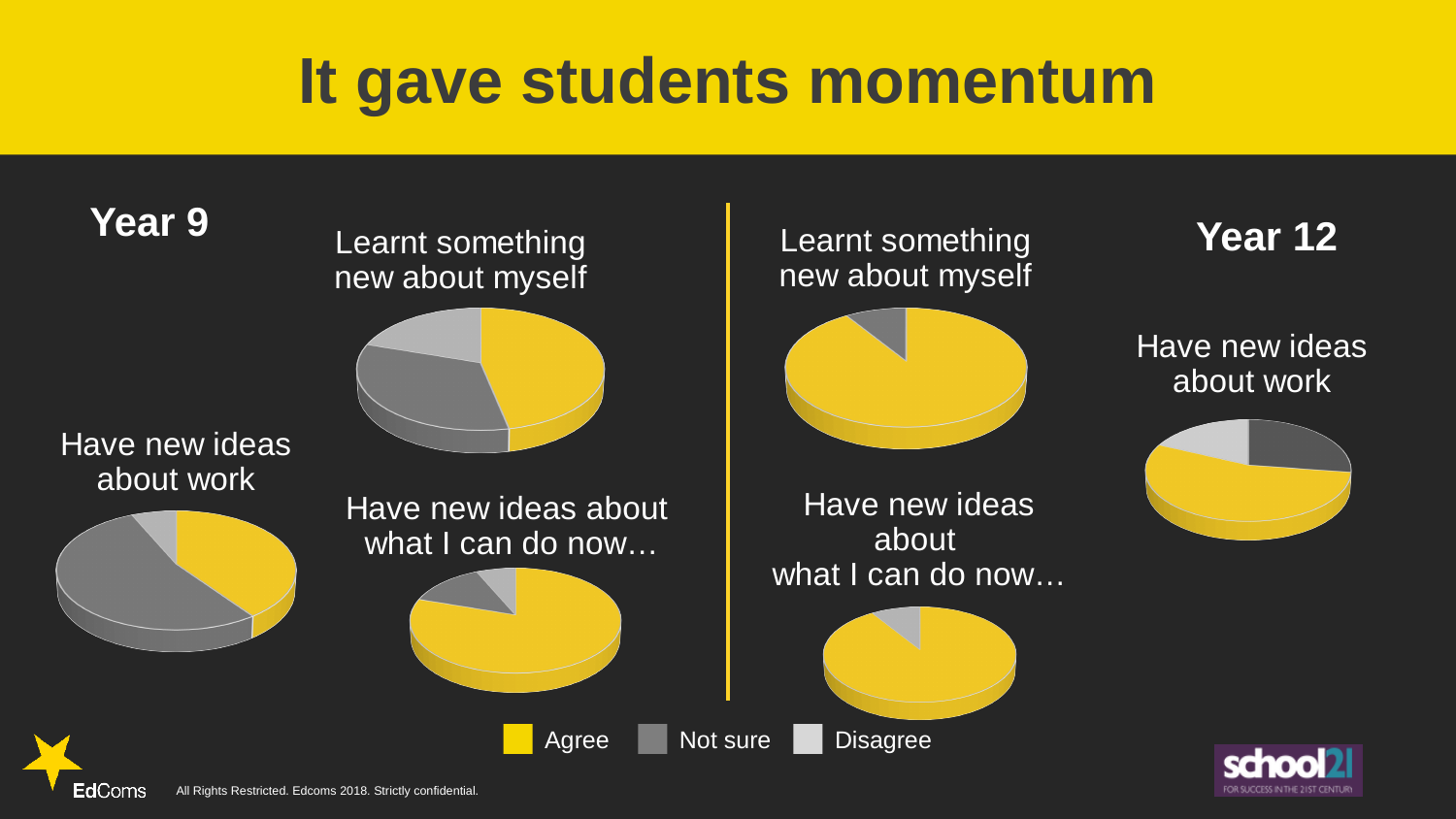
What is the title of the slide? It gave students momentum What kind of charts are shown on the slide? Pie charts In the Year 9 'Have new ideas about what I can do now…' pie chart, which response has the largest slice? Agree In the Year 9 'Learnt something new about myself' pie chart, which response has the largest slice? Agree How many response categories does the legend list? 3 In the Year 12 'Learnt something new about myself' pie chart, which response has the largest slice? Agree In the Year 9 'Have new ideas about work' pie chart, which response has the smallest slice? Disagree In the Year 12 'Have new ideas about work' pie chart, which response has the smallest slice? Disagree Which colour represents 'Agree' in the legend? Yellow How many pie charts are on the slide? 6